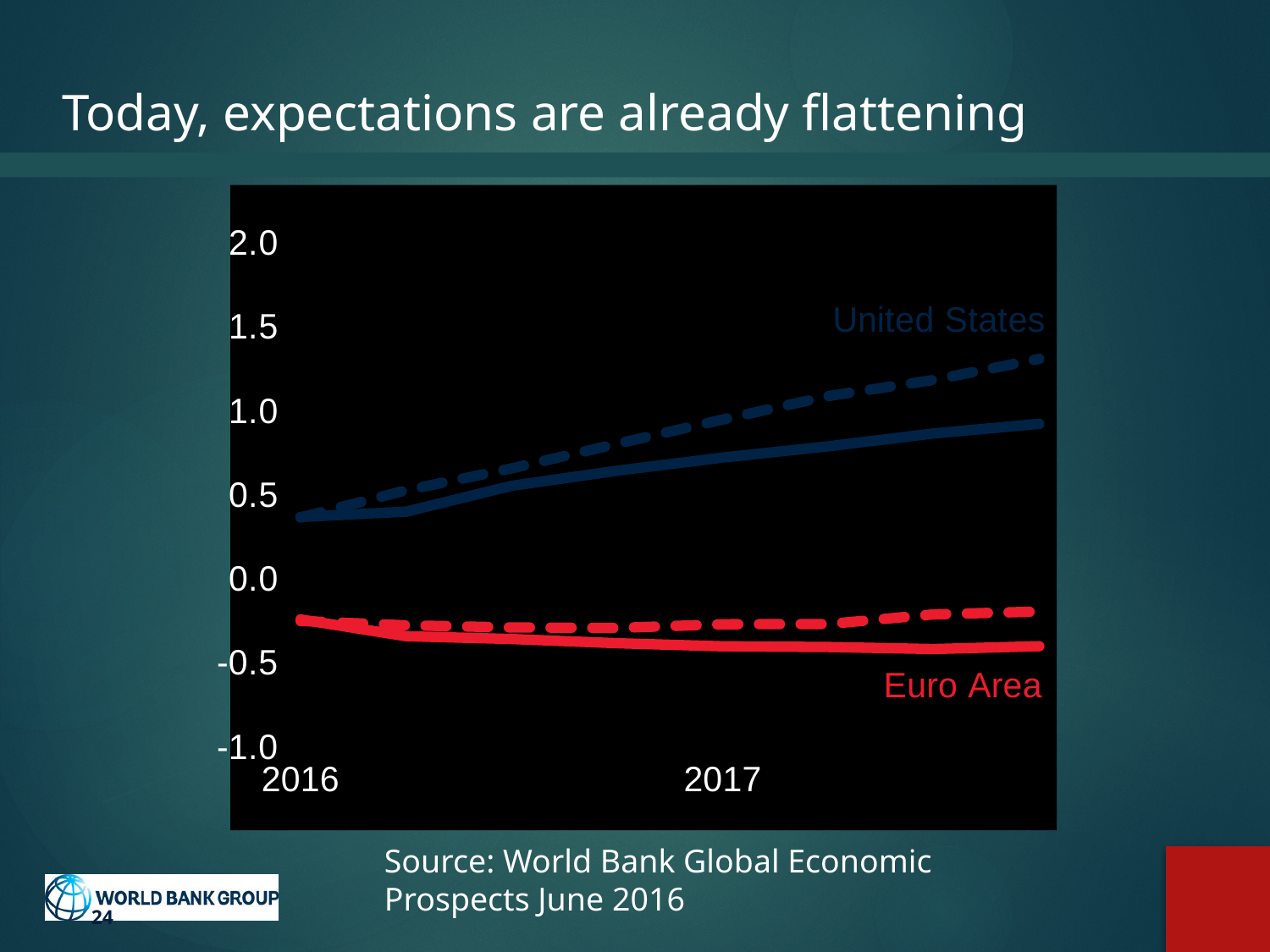
Which region has higher values throughout the chart, United States or Euro Area? United States Is the value of the solid United States line at the start of 2016 greater or less than 0.5? less What kind of chart is shown on the slide? line chart Which region's lines are drawn in red? Euro Area Is the value of the dashed United States line at the right end of the chart greater or less than 1.0? greater Do the United States lines rise or fall from 2016 to 2017? rise Does the solid Euro Area line rise or fall from 2016 to 2017? fall What is the title of the slide? Today, expectations are already flattening How many regions are labelled on the chart? 2 Is the value of the dashed Euro Area line at the right end of the chart greater or less than -0.5? greater Which region's lines are lowest on the chart? Euro Area